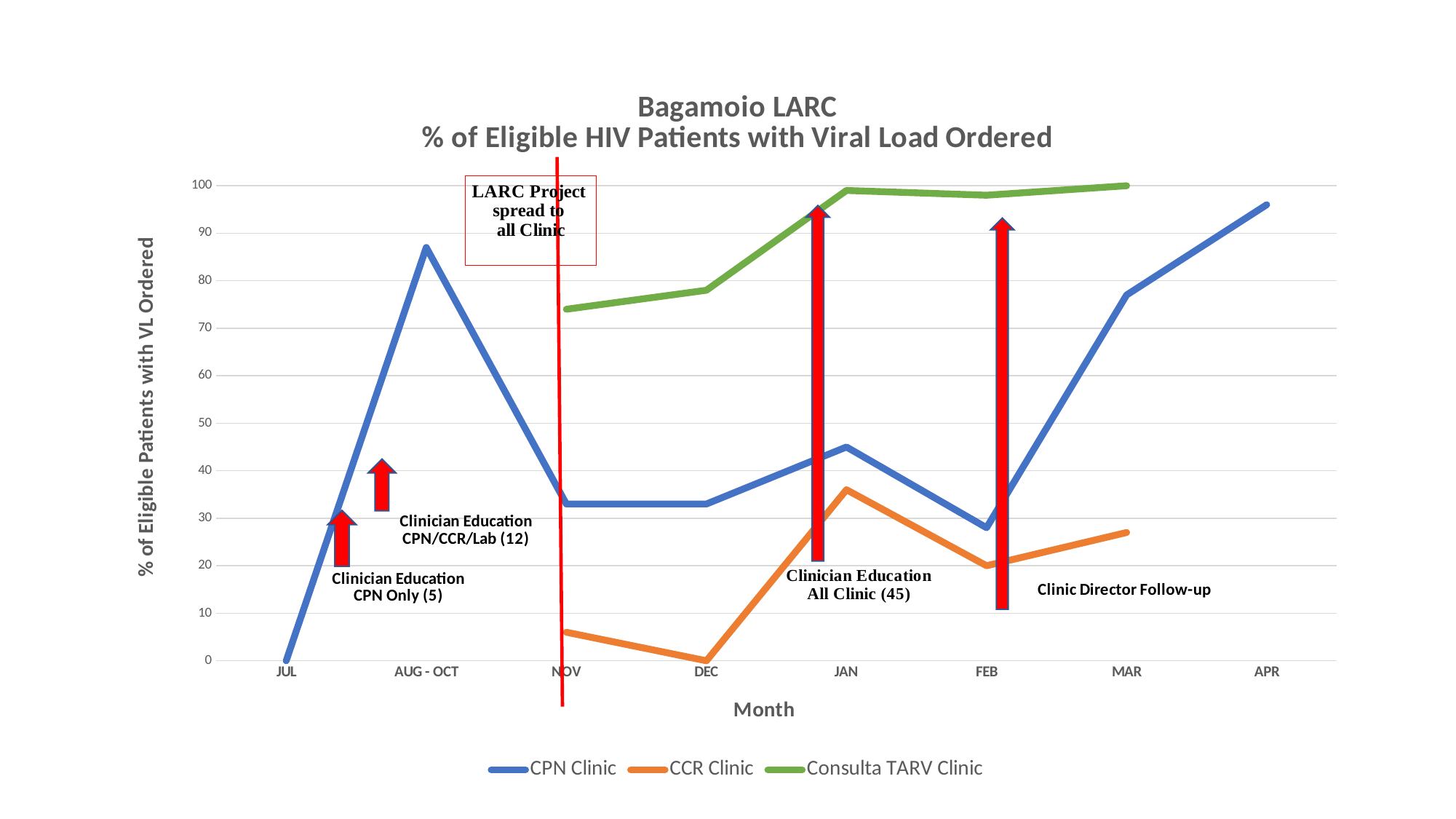
How many month categories are shown on the x axis? 8 In which month is the CPN Clinic value highest? APR What is the value for CPN Clinic in JUL? 0 Does the Consulta TARV Clinic line generally rise or fall from NOV to MAR? Rise In which month is the CCR Clinic value highest? JAN What is the value for CCR Clinic in DEC? 0 How many series does the legend list? 3 Is the value for Consulta TARV Clinic in NOV greater or less than 70? greater Is the value for CCR Clinic in FEB greater or less than 30? less What kind of chart is shown on the slide? Line chart In JAN, which series has the larger value, CPN Clinic or Consulta TARV Clinic? Consulta TARV Clinic Is the value for CPN Clinic in AUG - OCT greater or less than 80? greater